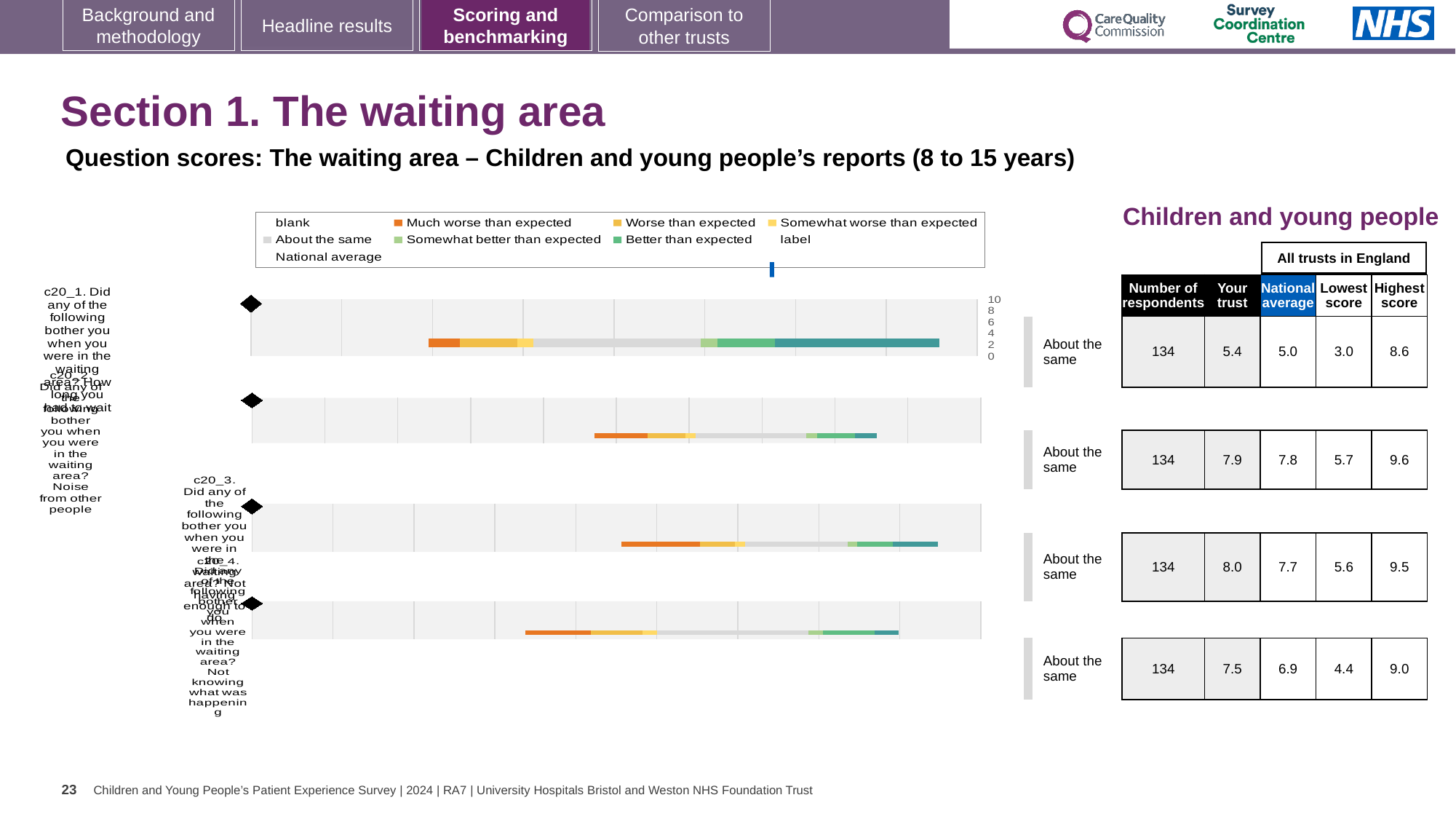
What is the difference between the highest score and the lowest score for the first bar (c20_1)? 5.6 What is the maximum value shown on the chart's score axis? 10 What kind of chart is shown on the slide? bar chart In the chart legend, which colour represents 'Much worse than expected'? orange Which question has the highest 'Your trust' score? c20_3 (8.0) What benchmark category is shown next to each of the four bars? About the same How many question bars are plotted in the chart? 4 What is the national average for the second bar (c20_2, how long you had to wait)? 7.8 How many respondents are listed for the third bar (c20_3)? 134 Which question has the lowest 'Your trust' score? c20_1 (5.4) What is the 'Your trust' score for the first bar (c20_1, noise from other people)? 5.4 For the fourth bar (c20_4), which is larger: the 'Your trust' score or the national average? Your trust (7.5)